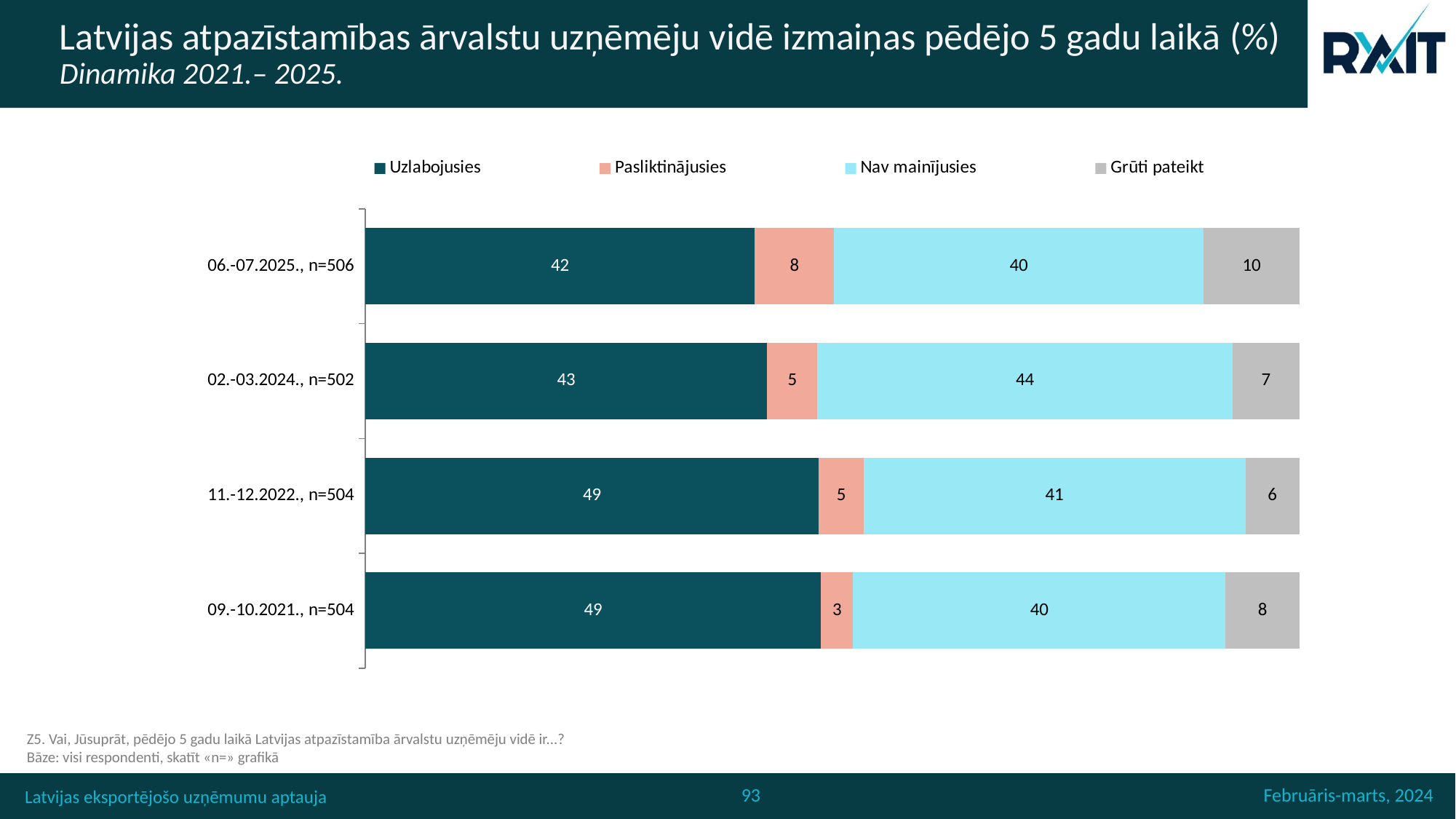
Which legend entry is shown in light blue? Nav mainījusies In which wave is the Uzlabojusies value lowest? 06.-07.2025., n=506 Does the Uzlabojusies value rise or fall from the 2021 wave to the 2025 wave? Fall How many survey waves (categories) are shown in the chart? 4 What is the value for Uzlabojusies in the 06.-07.2025., n=506 wave? 42 What is the difference between the Uzlabojusies values for 11.-12.2022., n=504 and 06.-07.2025., n=506? 7 What is the value for Nav mainījusies in the 02.-03.2024., n=502 wave? 44 What kind of chart is shown on the slide? Stacked bar chart Which is larger: the Nav mainījusies value for 02.-03.2024., n=502 or for 11.-12.2022., n=504? 02.-03.2024., n=502 What is the value for Pasliktinājusies in the 09.-10.2021., n=504 wave? 3 In which wave is the Grūti pateikt value highest? 06.-07.2025., n=506 How many series does the legend list? 4